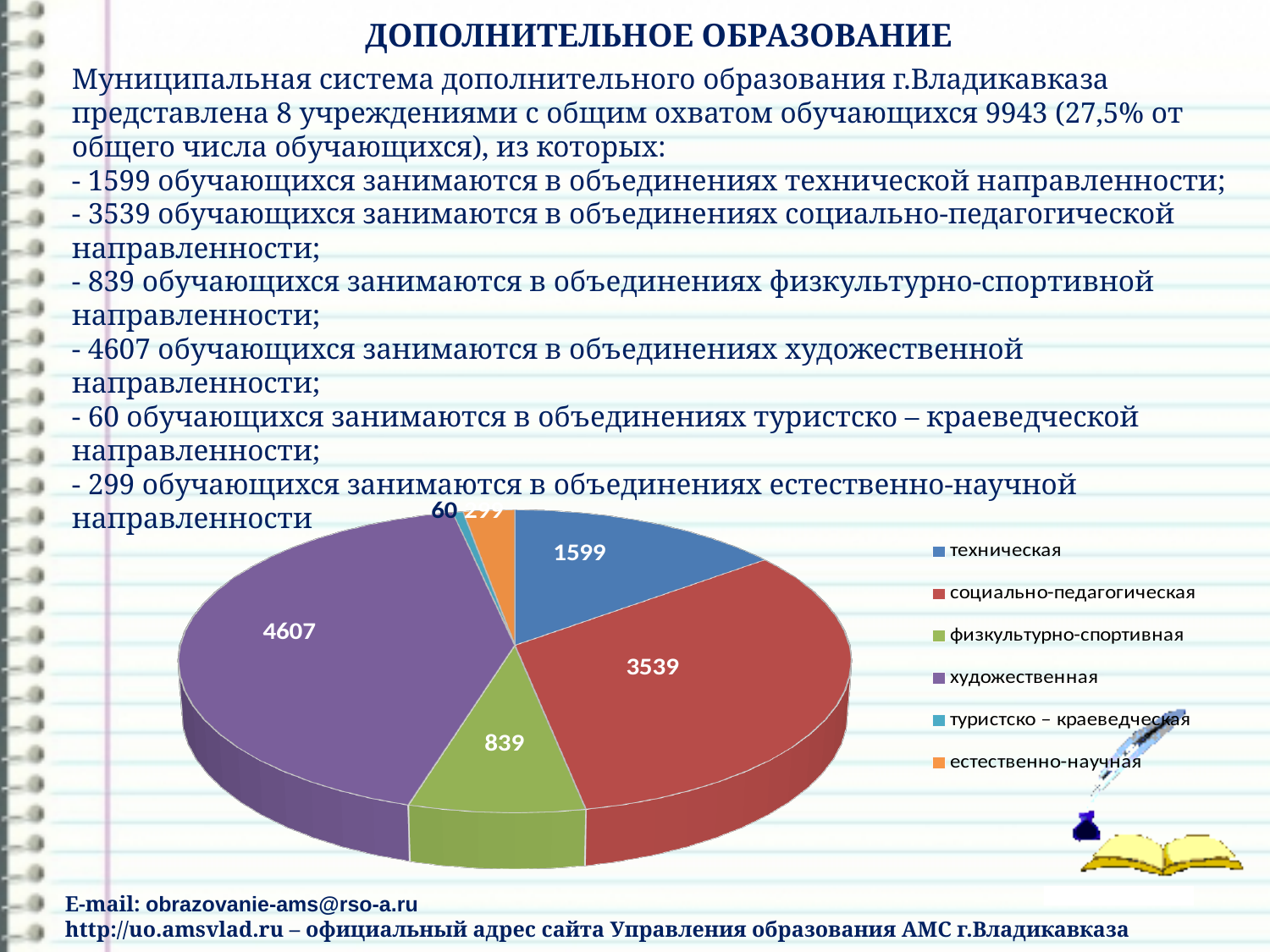
What is the value for the техническая slice? 1599 How many series does the legend list? 6 What is the value for the туристско – краеведческая slice? 60 What type of chart is shown on the slide? pie chart Which category has the smallest slice? туристско – краеведческая What is the value for the социально-педагогическая slice? 3539 Which category has the largest slice? художественная What is the value for the физкультурно-спортивная slice? 839 What is the difference between the художественная and социально-педагогическая values? 1068 Which is larger, the техническая slice or the физкультурно-спортивная slice? техническая What colour is the социально-педагогическая slice? red What is the value for the художественная slice? 4607